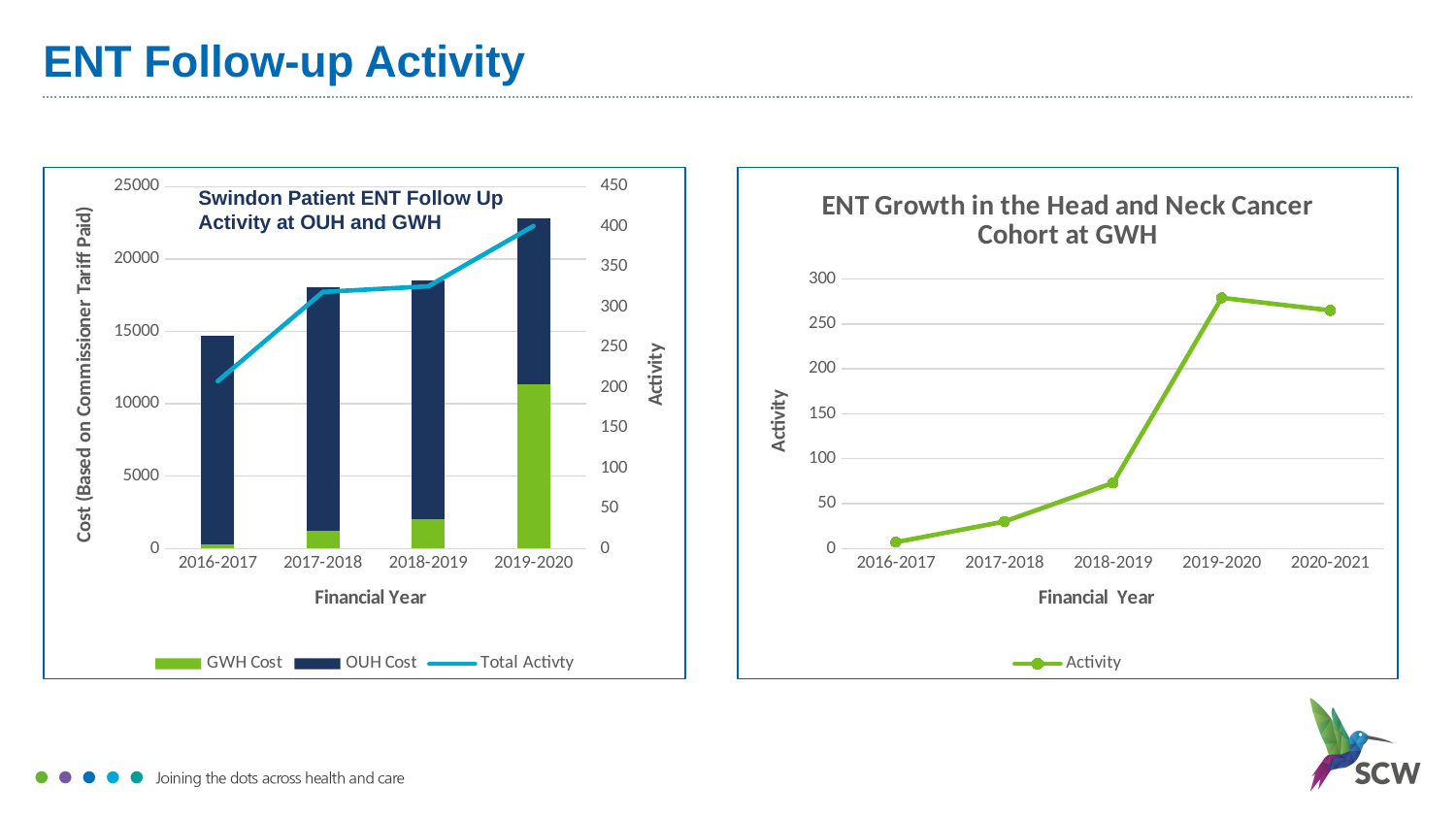
On the 'Swindon Patient ENT Follow Up Activity at OUH and GWH' chart, what is the label of the left vertical axis? Cost (Based on Commissioner Tariff Paid) How many financial years are plotted on the 'ENT Growth in the Head and Neck Cancer Cohort at GWH' chart? 5 On the 'Swindon Patient ENT Follow Up Activity at OUH and GWH' chart, which financial year has the tallest stacked cost bar? 2019-2020 On the 'ENT Growth in the Head and Neck Cancer Cohort at GWH' chart, is the activity for 2016-2017 greater or less than 50? less On the 'ENT Growth in the Head and Neck Cancer Cohort at GWH' chart, is the activity for 2019-2020 greater or less than 250? greater On the 'ENT Growth in the Head and Neck Cancer Cohort at GWH' chart, which financial year has the lowest activity? 2016-2017 On the 'ENT Growth in the Head and Neck Cancer Cohort at GWH' chart, which is larger, the activity for 2018-2019 or for 2017-2018? 2018-2019 On the 'ENT Growth in the Head and Neck Cancer Cohort at GWH' chart, which financial year has the highest activity? 2019-2020 On the 'Swindon Patient ENT Follow Up Activity at OUH and GWH' chart, is the Total Activity for 2019-2020 greater or less than 350? greater How many series does the legend list on the 'Swindon Patient ENT Follow Up Activity at OUH and GWH' chart? 3 How many financial years are shown on the 'Swindon Patient ENT Follow Up Activity at OUH and GWH' chart? 4 What kind of chart is the 'ENT Growth in the Head and Neck Cancer Cohort at GWH' chart on the right? Line chart